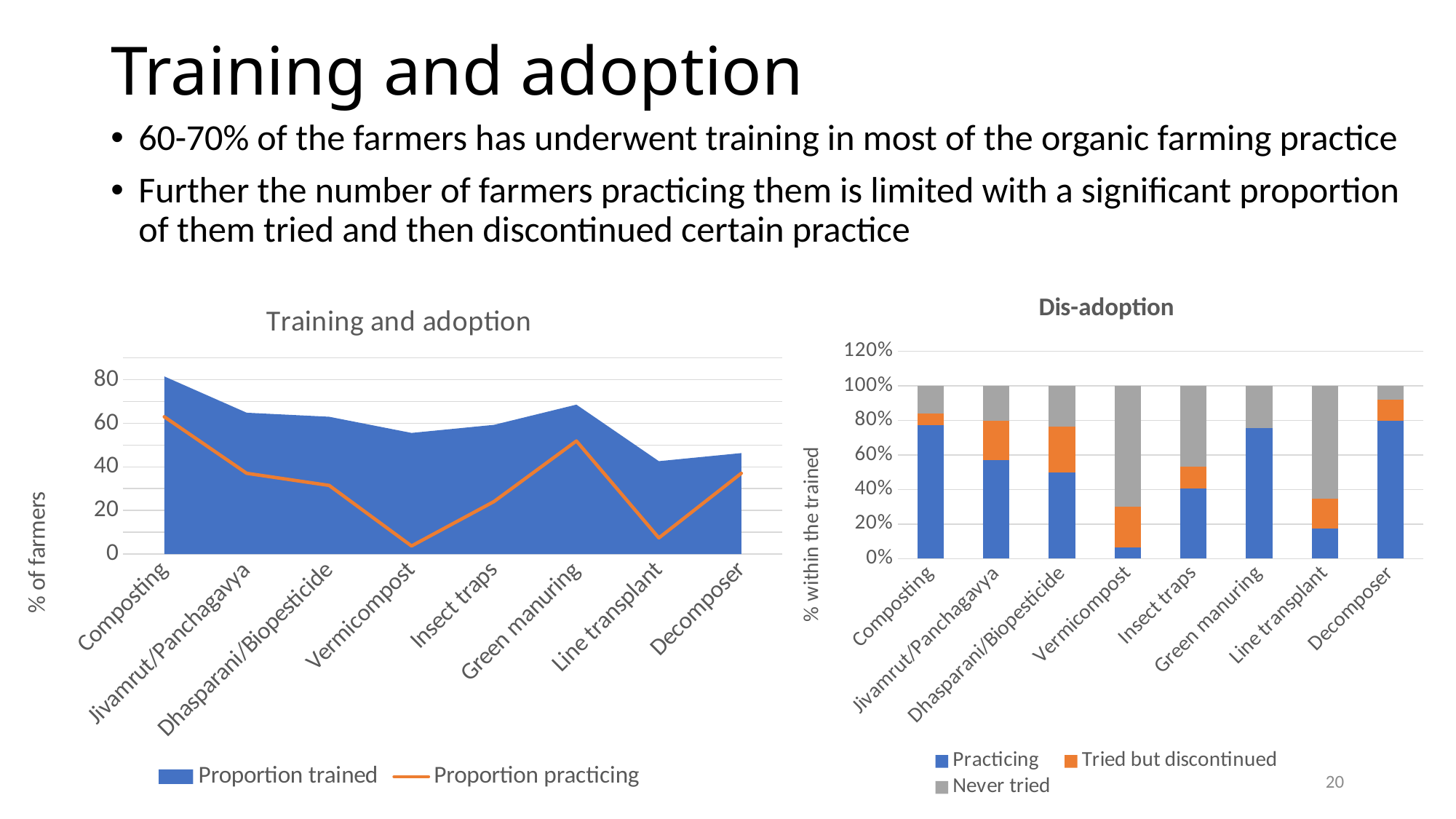
On the left chart titled "Training and adoption", is the proportion trained for Composting greater or less than 60? greater On the left chart titled "Training and adoption", which category has the lowest proportion practicing? Vermicompost On the right chart titled "Dis-adoption", how many categories are shown on the x axis? 8 On the left chart titled "Training and adoption", is the proportion practicing for Vermicompost greater or less than 20? less On the left chart titled "Training and adoption", which is larger: the proportion trained for Composting or for Decomposer? Composting On the left chart titled "Training and adoption", which category has the highest proportion trained? Composting On the right chart titled "Dis-adoption", what kind of chart is it? Stacked bar chart On the right chart titled "Dis-adoption", which series is shown in grey? Never tried On the left chart titled "Training and adoption", how many series does the legend list? 2 On the right chart titled "Dis-adoption", is the Practicing value for Line transplant greater or less than 20%? less On the right chart titled "Dis-adoption", which category has the lowest Practicing share? Vermicompost On the right chart titled "Dis-adoption", which category has the highest Practicing share? Decomposer